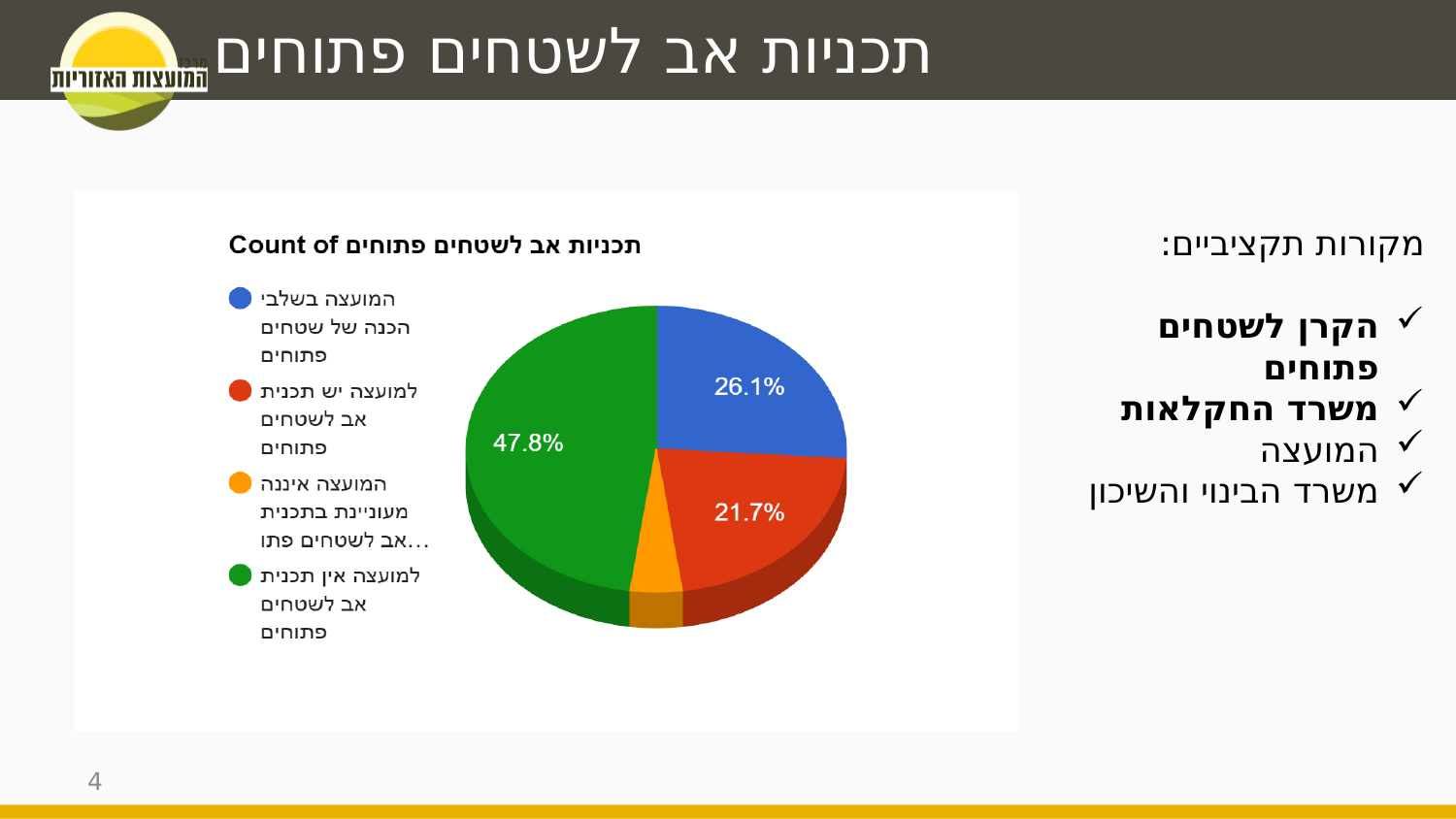
How many slices does the pie chart have? 4 What share of the pie is the slice for 'למועצה אין תכנית אב לשטחים פתוחים'? 47.8% What share of the pie is the slice for 'המועצה בשלבי הכנה של שטחים פתוחים'? 26.1% What share of the pie is the slice for 'למועצה יש תכנית אב לשטחים פתוחים'? 21.7% What kind of chart is shown on the slide? pie chart Which slice is larger: 'המועצה בשלבי הכנה של שטחים פתוחים' or 'למועצה יש תכנית אב לשטחים פתוחים'? המועצה בשלבי הכנה של שטחים פתוחים What colour is the slice for 'למועצה אין תכנית אב לשטחים פתוחים'? green What is the title of the chart? Count of תכניות אב לשטחים פתוחים Which category has the smallest slice of the pie? המועצה איננה מעוניינת בתכנית אב לשטחים פתו... What is the difference in percentage points between the 'המועצה בשלבי הכנה של שטחים פתוחים' slice and the 'למועצה יש תכנית אב לשטחים פתוחים' slice? 4.4 What is the difference in percentage points between the 'למועצה אין תכנית אב לשטחים פתוחים' slice and the 'המועצה בשלבי הכנה של שטחים פתוחים' slice? 21.7 Which category has the largest slice of the pie? למועצה אין תכנית אב לשטחים פתוחים